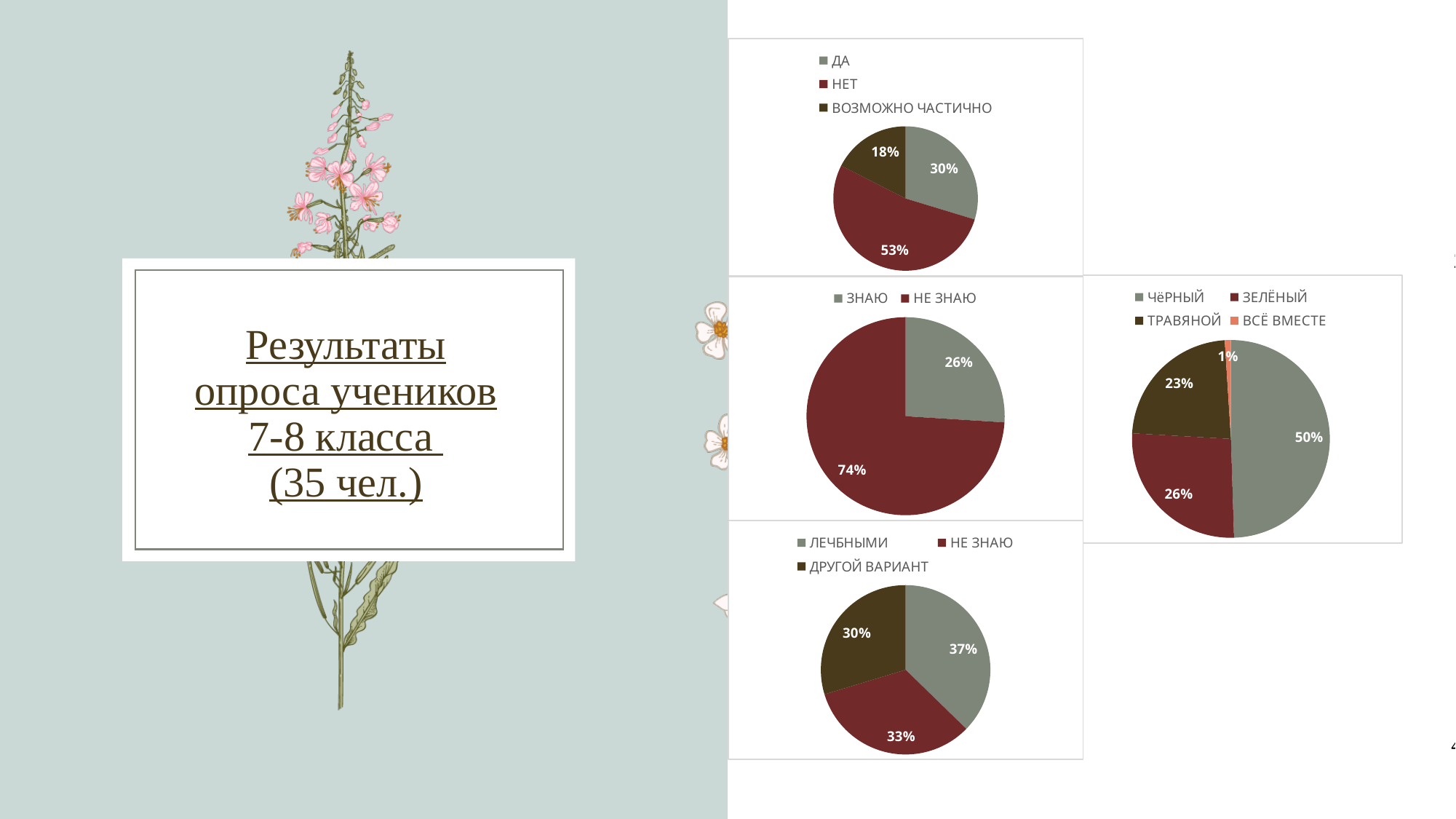
In the bottom pie chart (legend ЛЕЧБНЫМИ / НЕ ЗНАЮ / ДРУГОЙ ВАРИАНТ), what share does ЛЕЧБНЫМИ have? 37% In the right pie chart (legend ЧёРНЫЙ / ЗЕЛЁНЫЙ / ТРАВЯНОЙ / ВСЁ ВМЕСТЕ), what share does ЧёРНЫЙ have? 50% In the top pie chart (legend ДА / НЕТ / ВОЗМОЖНО ЧАСТИЧНО), what share does ВОЗМОЖНО ЧАСТИЧНО have? 18% In the middle-left pie chart (legend ЗНАЮ / НЕ ЗНАЮ), what is the difference between the НЕ ЗНАЮ and ЗНАЮ shares? 48% How many slices does the right pie chart (legend ЧёРНЫЙ / ЗЕЛЁНЫЙ / ТРАВЯНОЙ / ВСЁ ВМЕСТЕ) have? 4 In the right pie chart (legend ЧёРНЫЙ / ЗЕЛЁНЫЙ / ТРАВЯНОЙ / ВСЁ ВМЕСТЕ), which category has the smallest slice? ВСЁ ВМЕСТЕ In the top pie chart (legend ДА / НЕТ / ВОЗМОЖНО ЧАСТИЧНО), which category has the largest slice? НЕТ How many categories does the legend of the middle-left pie chart (ЗНАЮ / НЕ ЗНАЮ) list? 2 What kind of chart is the bottom chart (legend ЛЕЧБНЫМИ / НЕ ЗНАЮ / ДРУГОЙ ВАРИАНТ)? Pie chart